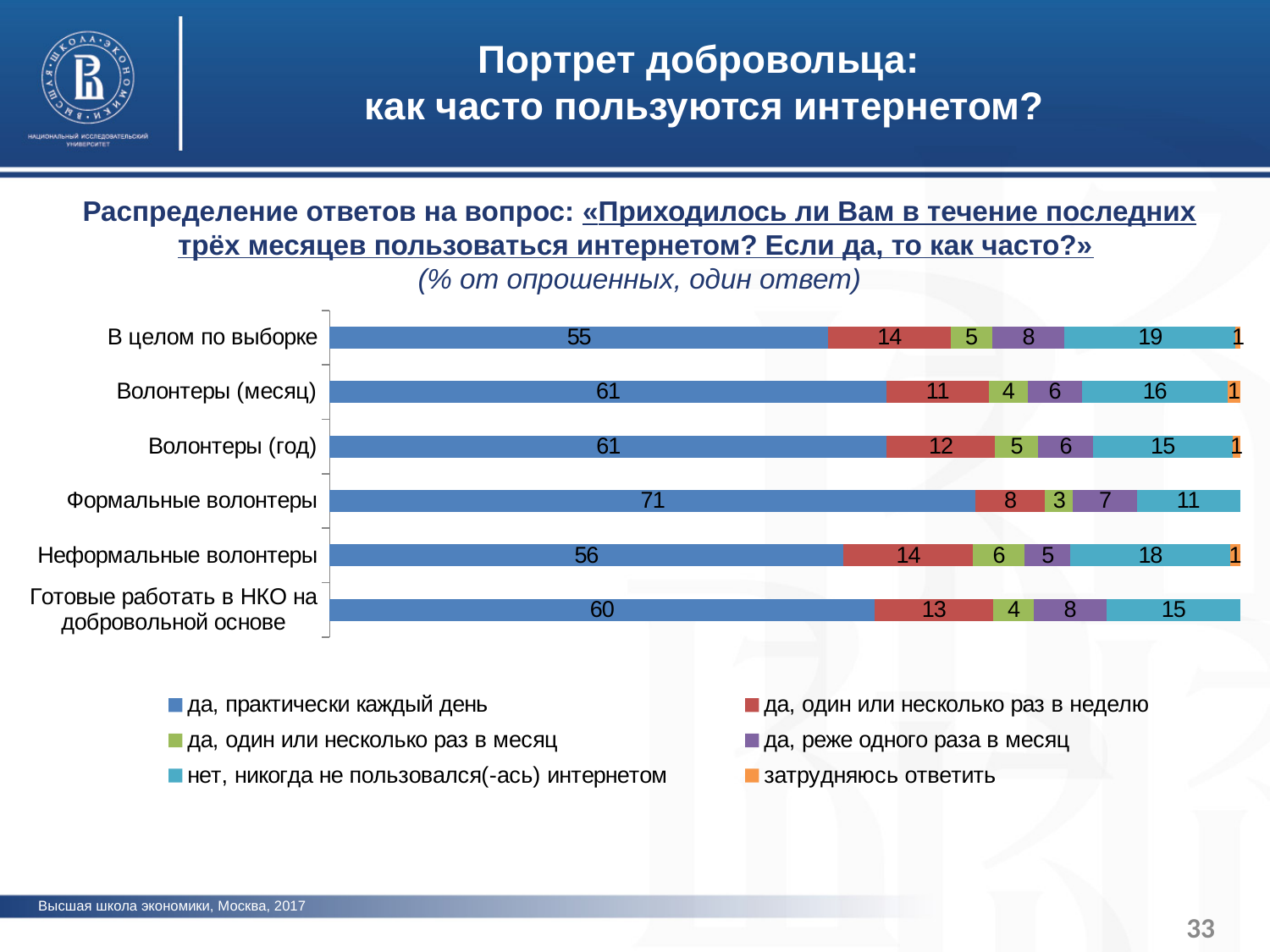
What is the value for "да, практически каждый день" in the category "Формальные волонтеры"? 71 How many categories (groups of respondents) are shown on the chart? 6 Which legend entry is shown in orange? затрудняюсь ответить What type of chart is shown on the slide? Stacked bar chart What is the total of the labelled segments in the bar for "Формальные волонтеры"? 100 How many series does the legend list? 6 Which category has the highest value for "да, практически каждый день"? Формальные волонтеры Which is larger: the "нет, никогда не пользовался(-ась) интернетом" value for "Неформальные волонтеры" or for "Формальные волонтеры"? Неформальные волонтеры Which category has the lowest value for "да, практически каждый день"? В целом по выборке What is the value for "да, один или несколько раз в неделю" in the category "Готовые работать в НКО на добровольной основе"? 13 What is the value for "нет, никогда не пользовался(-ась) интернетом" in the category "В целом по выборке"? 19 What is the difference between the "да, практически каждый день" values for "Формальные волонтеры" and "Неформальные волонтеры"? 15